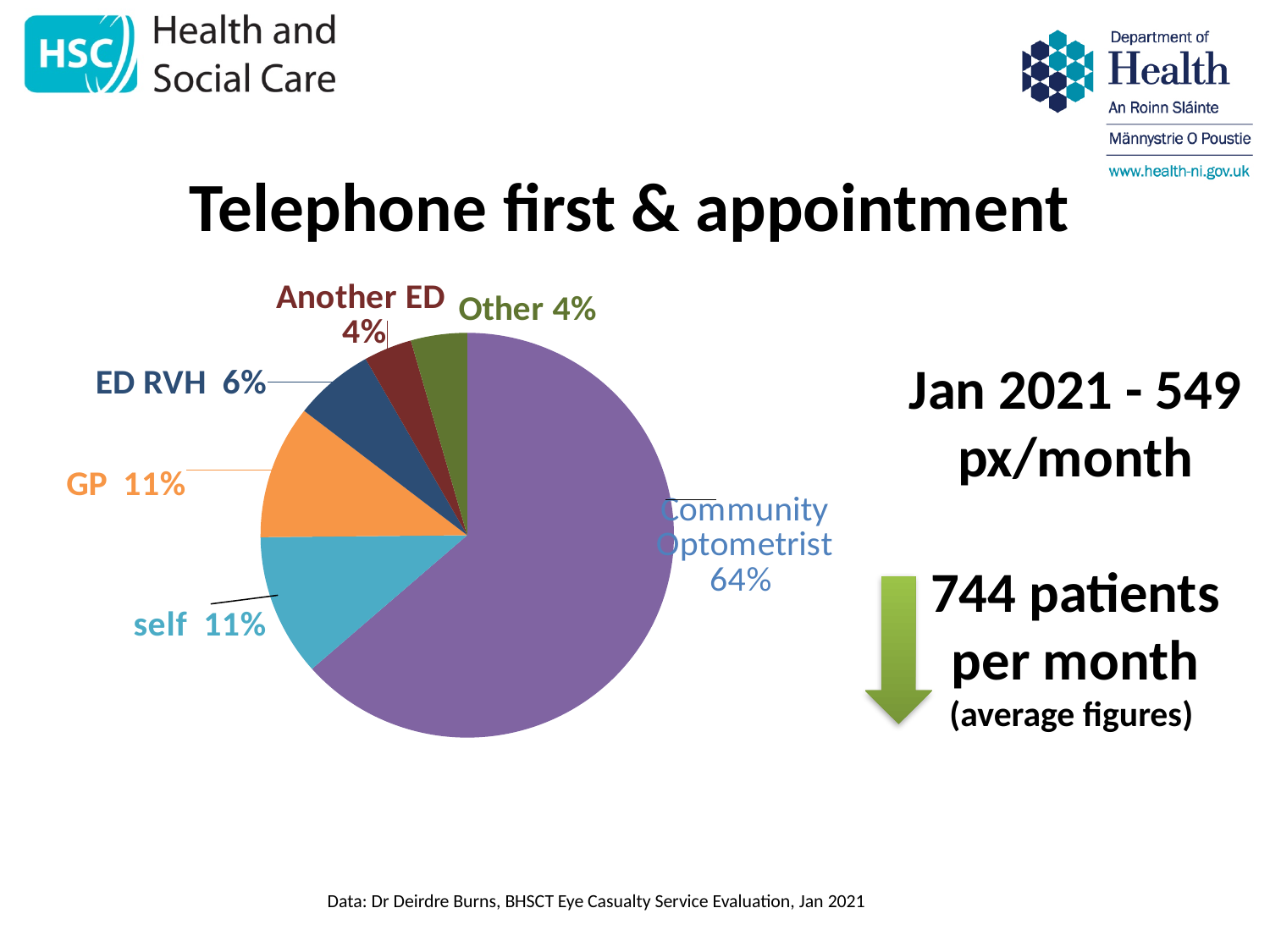
What is the value shown for self? 11% What is the difference between the Community Optometrist share and the GP share? 53% Which is larger, the share for ED RVH or the share for Other? ED RVH What kind of chart is shown on the slide? Pie chart How many slices does the pie chart have? 6 What is the value shown for GP? 11% What colour is the Community Optometrist slice? Purple What is the value shown for Another ED? 4% What is the value shown for ED RVH? 6% What is the difference between the ED RVH share and the Another ED share? 2% What share of the pie does Community Optometrist account for? 64% Which category has the largest slice of the pie? Community Optometrist